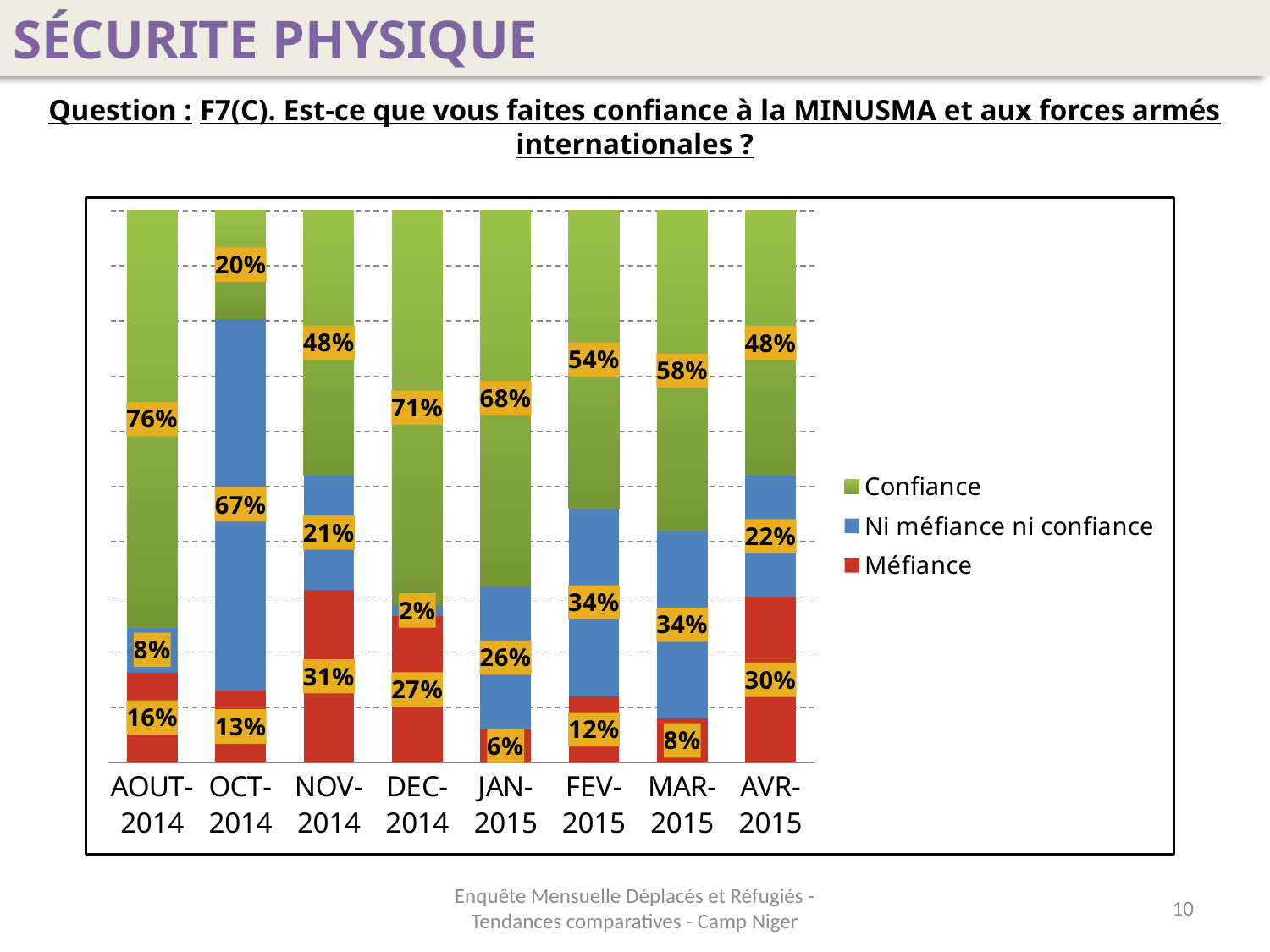
What is the difference between the Confiance values for DEC-2014 and JAN-2015? 3% Which month has the highest Confiance value? AOUT-2014 What is the Méfiance value for NOV-2014? 31% What is the Méfiance value for JAN-2015? 6% How many months are shown on the x axis? 8 Which is larger, the Méfiance value for AVR-2015 or for DEC-2014? AVR-2015 What is the Confiance value for AOUT-2014? 76% Which month has the lowest Confiance value? OCT-2014 What kind of chart is shown on the slide? Stacked bar chart What is the Ni méfiance ni confiance value for OCT-2014? 67% Which month has the lowest Ni méfiance ni confiance value? DEC-2014 How many series does the legend list? 3